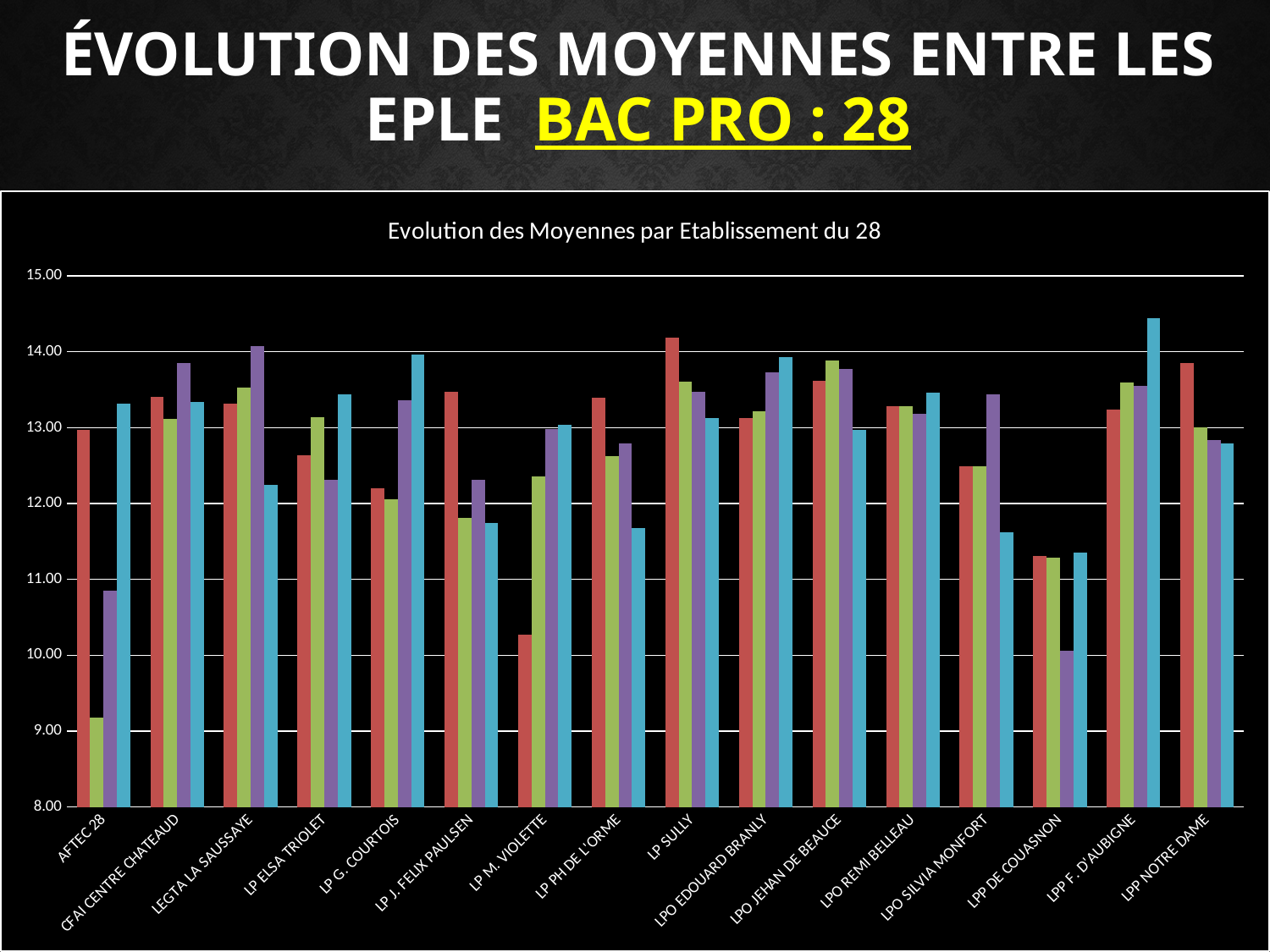
What is the title of the chart? Evolution des Moyennes par Etablissement du 28 Which establishment has the tallest bar in the chart? LPP F. D'AUBIGNE How many bars are plotted for each establishment in the chart? 4 Which establishment has the lowest bar in the chart? AFTEC 28 What kind of chart is shown on the slide? bar chart Is the value of the blue bar for LPP F. D'AUBIGNE greater or less than 14.00? greater Is the value of the red bar for LP M. VIOLETTE greater or less than 11.00? less Is the value of the red bar for LP SULLY greater or less than 14.00? greater How many establishments (categories) are shown on the x axis of the chart? 16 What is the highest value shown on the y axis of the chart? 15.00 Which has the larger red bar, AFTEC 28 or LPP DE COUASNON? AFTEC 28